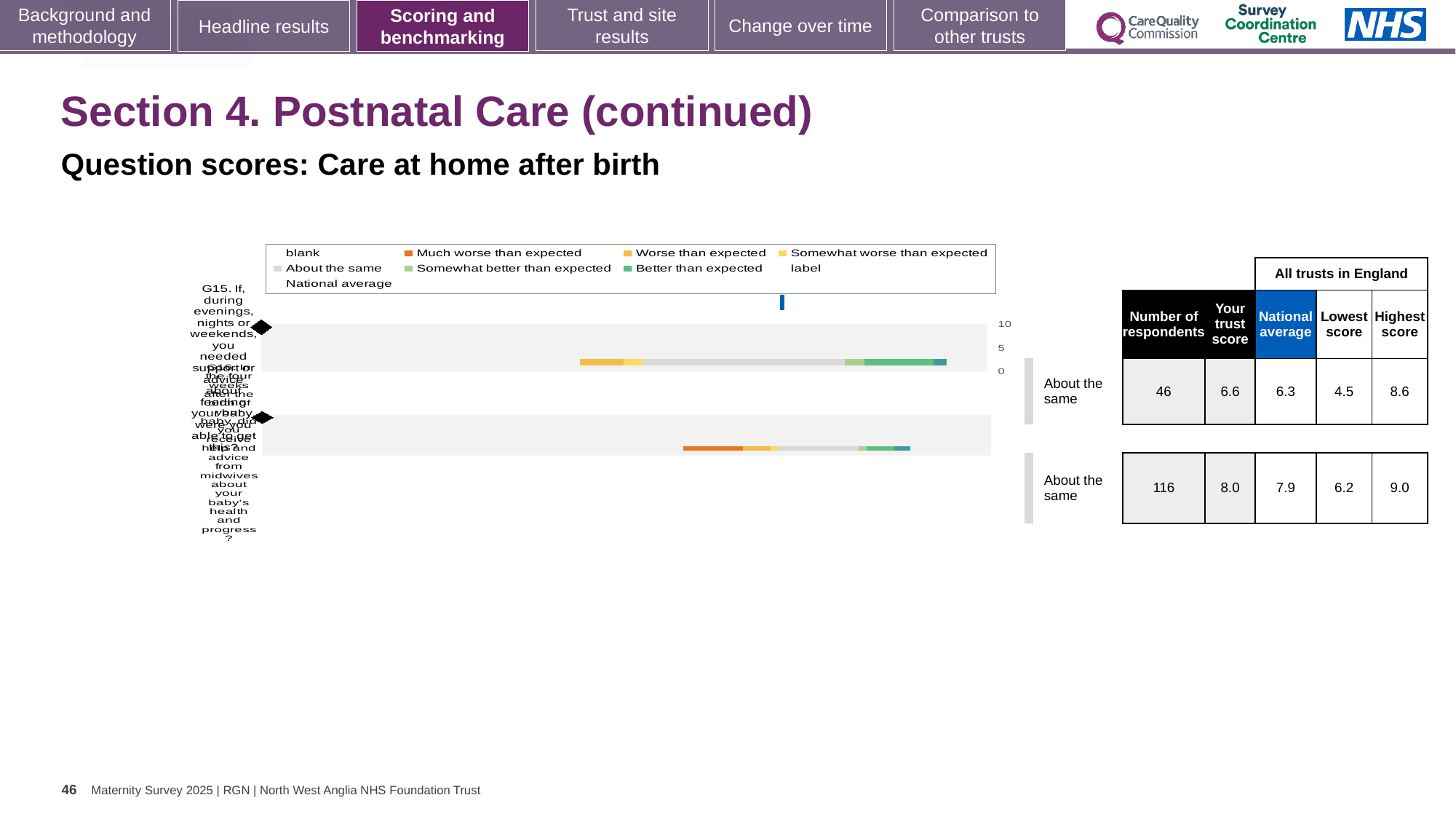
In the table, what is the national average for the top row? 6.3 What is the difference between the trust score and the national average for the bottom row? 0.1 Which row has the larger number of respondents, the top row or the bottom row? bottom row In the table, what is the lowest score for the bottom row? 6.2 How many question rows (bars) does the chart show? 2 What is the difference between the highest and lowest score for the top row? 4.1 What colour does the legend use for 'Much worse than expected'? orange In the table, what is the number of respondents for the top row? 46 What benchmark category is shown for both rows? About the same What kind of chart is shown on the slide? bar chart In the table, what is the highest score for the bottom row? 9.0 In the table, what is the trust score for the top row? 6.6